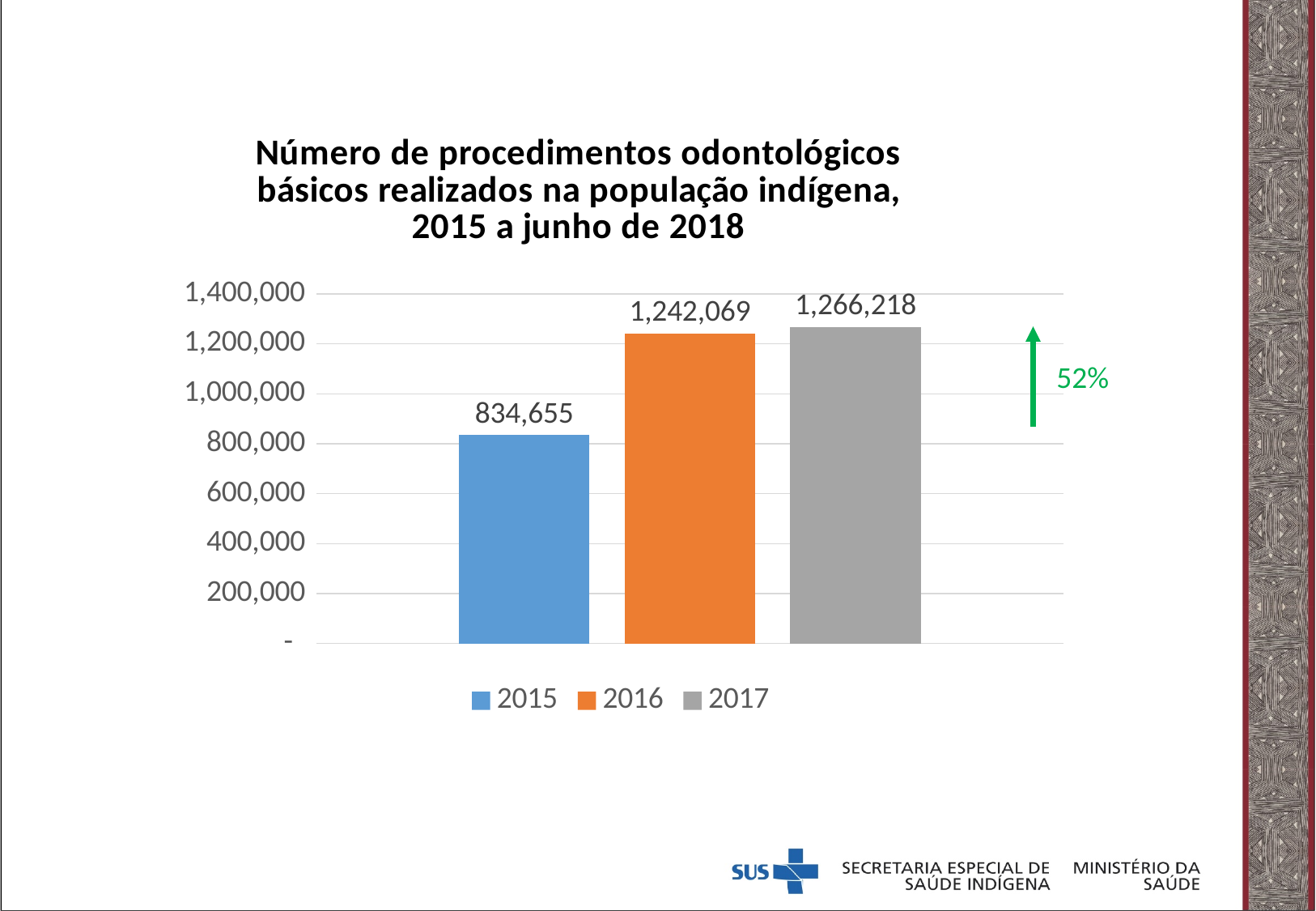
What is the value for 2016? 1,242,069 Which is larger, the value for 2015 or the value for 2016? 2016 Which year has the highest number of procedures? 2017 What is the difference between the values for 2016 and 2015? 407,414 Which year has the lowest number of procedures? 2015 Is the value for 2015 greater or less than 1,000,000? less How many series does the legend list? 3 How many bars are shown in the chart? 3 What is the value for 2015? 834,655 What kind of chart is shown on the slide? bar chart What is the difference between the values for 2017 and 2016? 24,149 What is the value for 2017? 1,266,218